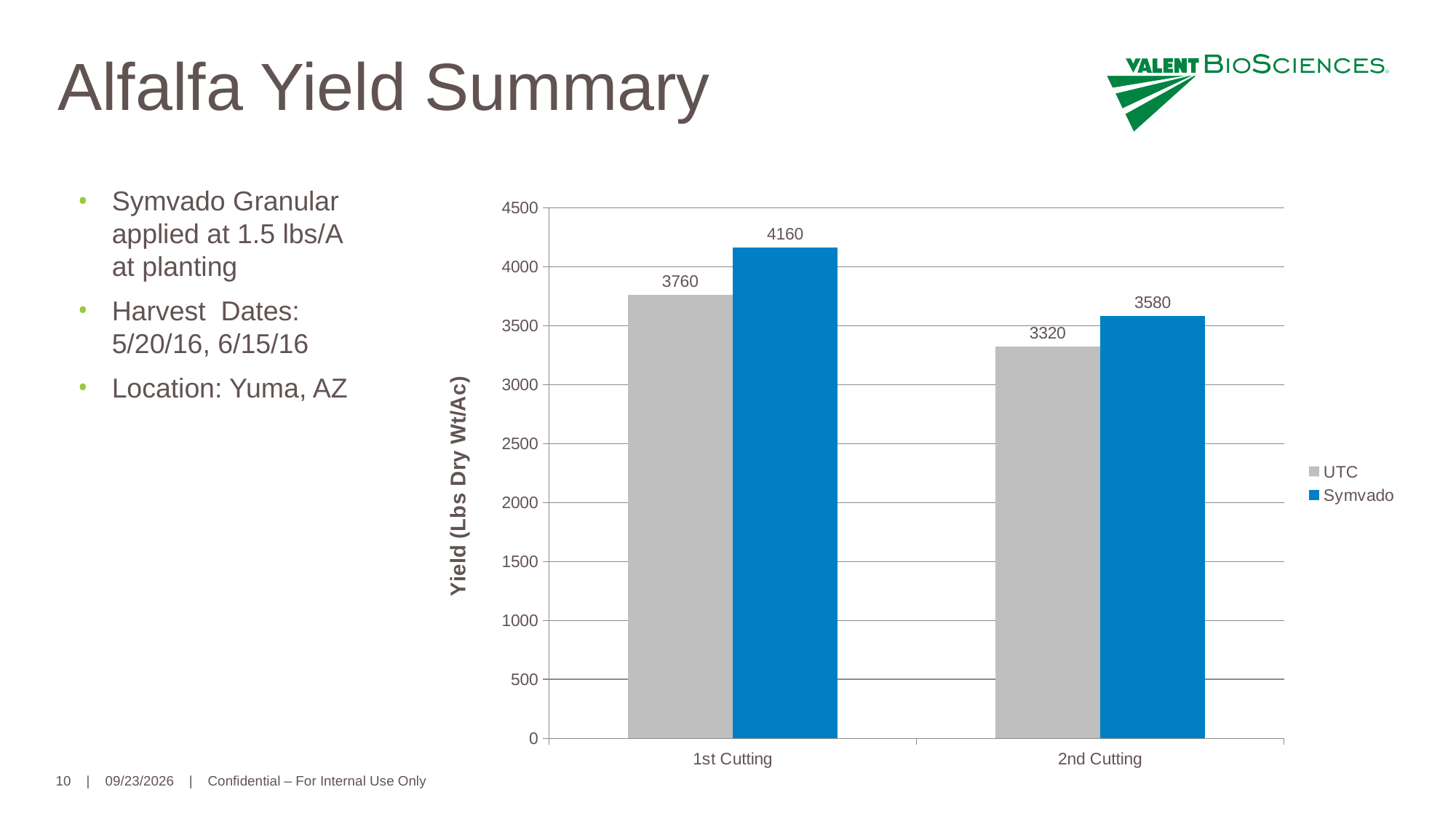
What kind of chart is shown on the slide? bar chart Which bar has the lowest yield on the chart? UTC, 2nd Cutting What is the Symvado yield for the 2nd Cutting? 3580 Which bar has the highest yield on the chart? Symvado, 1st Cutting What is the difference between the Symvado and UTC yields for the 2nd Cutting? 260 What is the difference between the Symvado and UTC yields for the 1st Cutting? 400 Which is larger for the 2nd Cutting, the UTC yield or the Symvado yield? Symvado What is the UTC yield for the 1st Cutting? 3760 How many series does the legend list? 2 What is the label of the y axis? Yield (Lbs Dry Wt/Ac) What is the Symvado yield for the 1st Cutting? 4160 Is the UTC yield for the 2nd Cutting greater or less than 3500? less